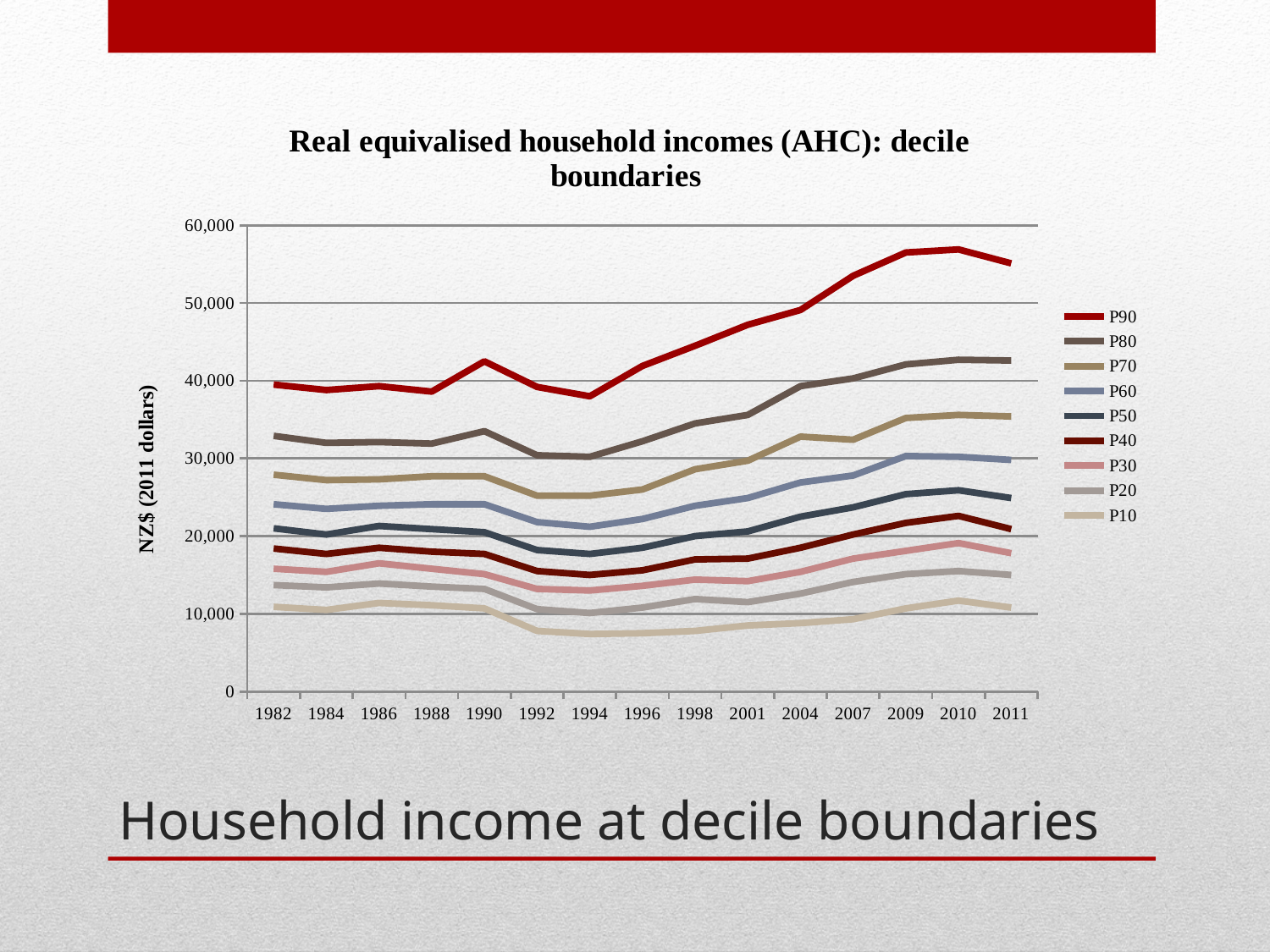
Is the value for P80 in 1994 greater or less than 40,000? less Which is larger in 2011, the value for P70 or the value for P60? P70 Which series has the highest values across the chart? P90 Which series has the lowest values across the chart? P10 What kind of chart is shown on the slide? Line chart Does the P90 series rise or fall between 1994 and 2009? Rise Is the value for P50 in 2009 greater or less than 20,000? greater What is the label on the vertical axis? NZ$ (2011 dollars) How many years are shown along the x axis? 15 How many series does the legend list? 9 Is the value for P90 in 2010 greater or less than 50,000? greater